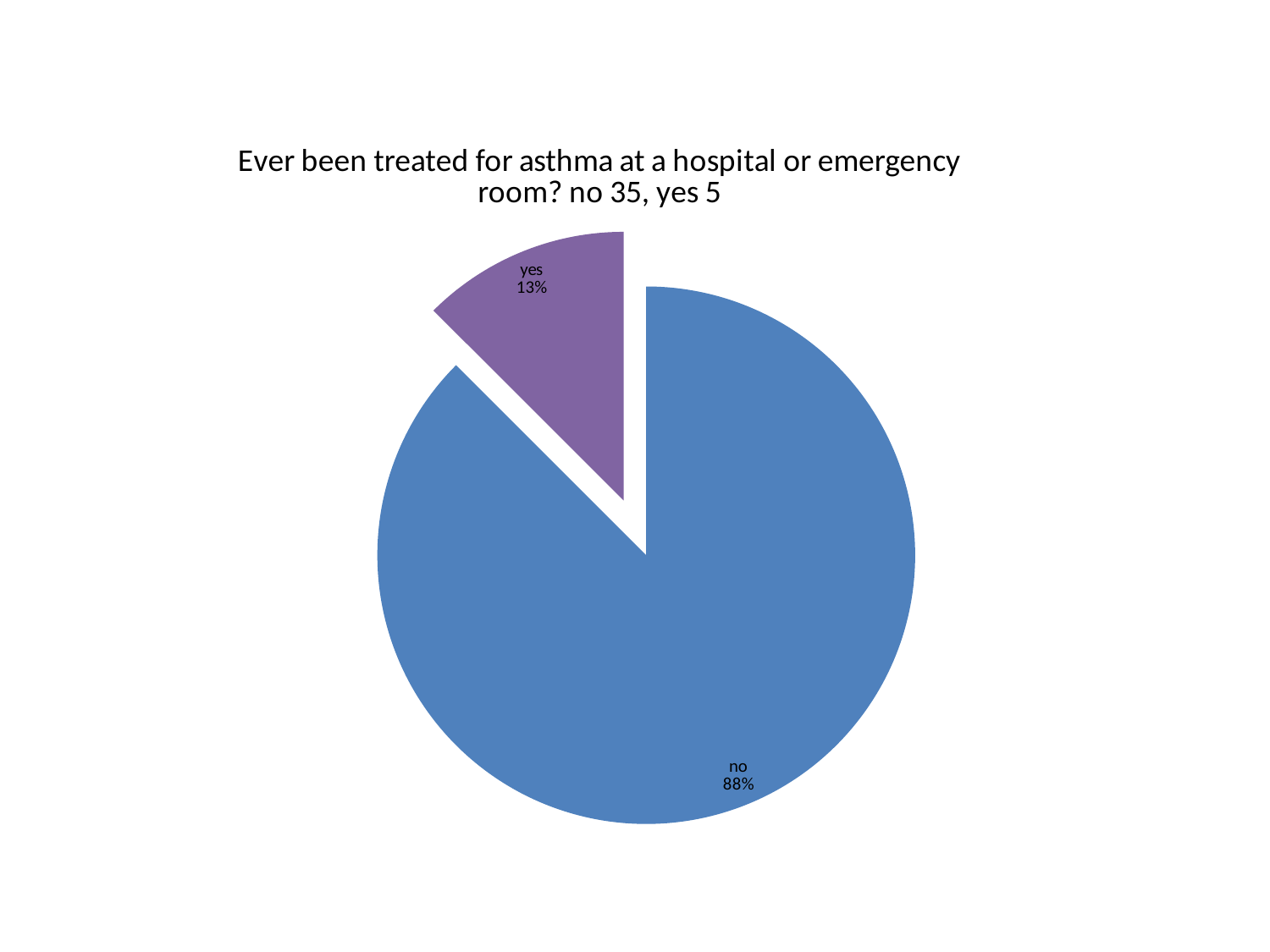
How many slices does the pie chart have? 2 What colour is the "yes" slice? purple According to the chart title, how many respondents answered "yes"? 5 What is the difference in percentage points between the "no" and "yes" slices? 75 Which is larger, the "yes" slice or the "no" slice? no What is the title of the chart? Ever been treated for asthma at a hospital or emergency room? no 35, yes 5 Which slice is the smallest? yes What percentage share does the "no" slice have? 88% According to the chart title, how many respondents answered "no"? 35 Which slice is the largest? no What percentage share does the "yes" slice have? 13% What kind of chart is shown on the slide? pie chart